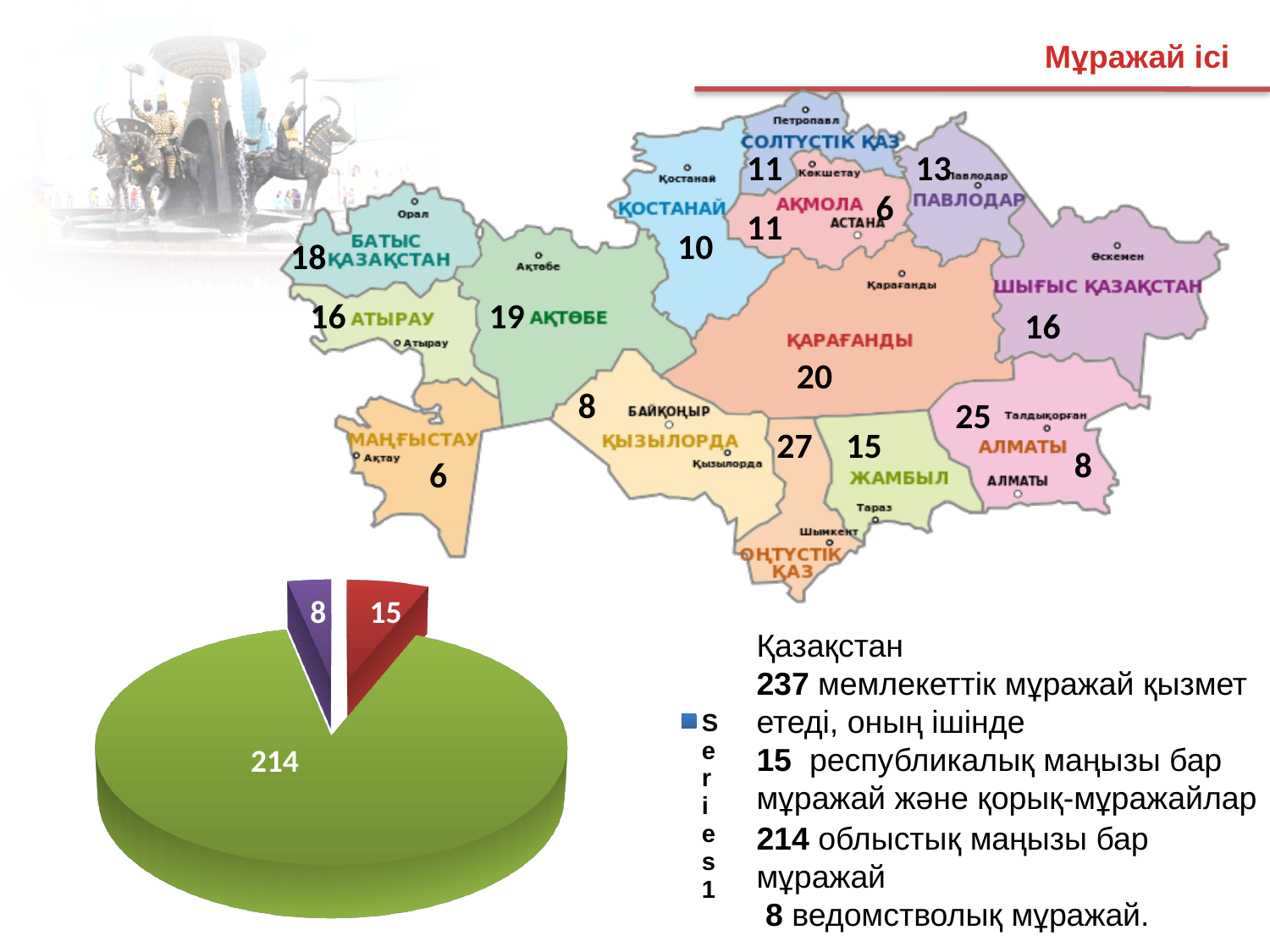
Which slice of the pie chart has the largest value? the green slice (214) What is the value of the large green slice of the pie chart? 214 How many slices does the pie chart have? 3 How many series does the legend of the pie chart list? 1 What is the difference between the green slice (214) and the red slice (15) in the pie chart? 199 Which is larger in the pie chart, the red slice or the purple slice? the red slice Which slice of the pie chart has the smallest value? the purple slice (8) What is the value of the red slice of the pie chart? 15 What is the legend entry shown next to the pie chart? Series 1 What is the total of all slices in the pie chart? 237 What kind of chart is shown at the bottom left of the slide? pie chart What is the value of the purple slice of the pie chart? 8